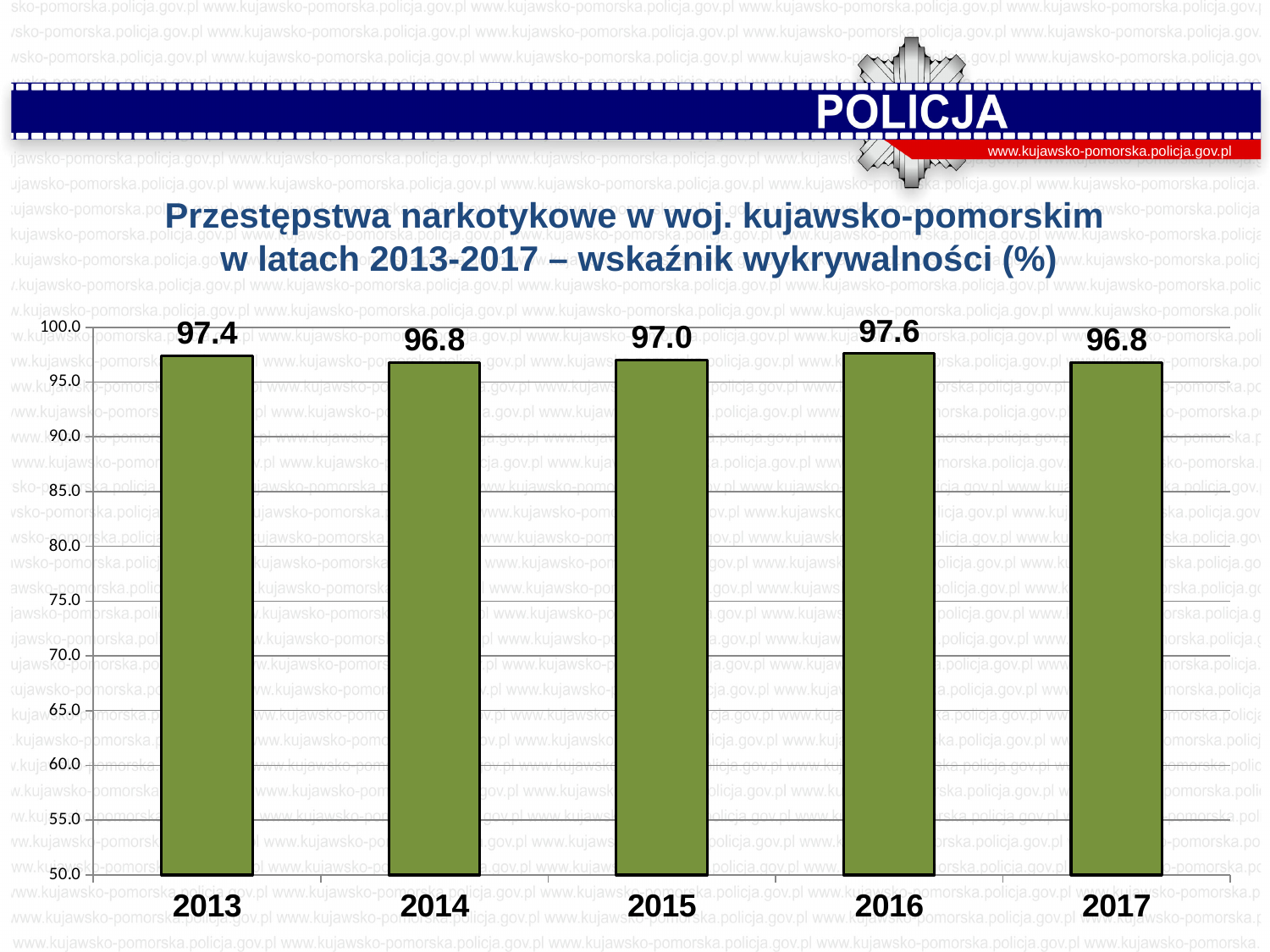
How many years are shown on the x axis? 5 Is the value for 2017 greater or less than 95.0? greater What is the value shown for 2015? 97.0 What is the lowest value shown on the vertical axis? 50.0 What is the difference between the values for 2016 and 2014? 0.8 What is the detection rate value shown for 2013? 97.4 Which year has the highest value? 2016 What kind of chart is shown on the slide? bar chart Do the values for 2014 and 2017 match? Yes, both are 96.8 What is the difference between the values for 2013 and 2015? 0.4 What is the value shown for 2016? 97.6 Which is larger, the value for 2013 or the value for 2015? 2013